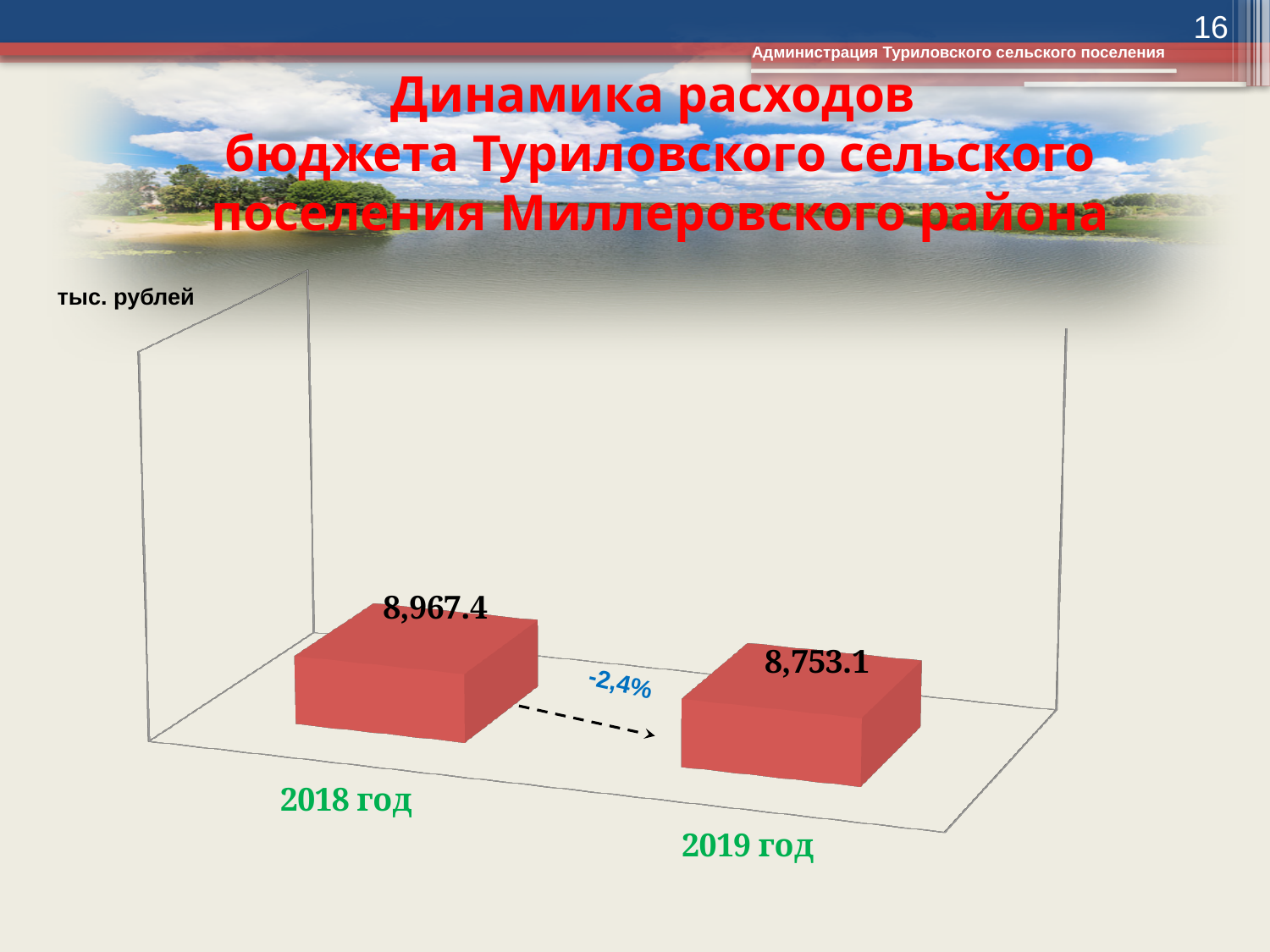
What is the difference between the values for 2018 год and 2019 год? 214.3 What percentage change is annotated between the two bars? -2,4% Do the values rise or fall from 2018 год to 2019 год? Fall What is the value shown for 2018 год? 8,967.4 Which category has the lowest value on the chart? 2019 год Which category has the highest value on the chart? 2018 год Which year has the higher value, 2018 год or 2019 год? 2018 год What is the value shown for 2019 год? 8,753.1 What kind of chart is shown on the slide? Bar chart What unit of measurement is indicated on the chart? тыс. рублей How many categories (bars) are plotted on the chart? 2